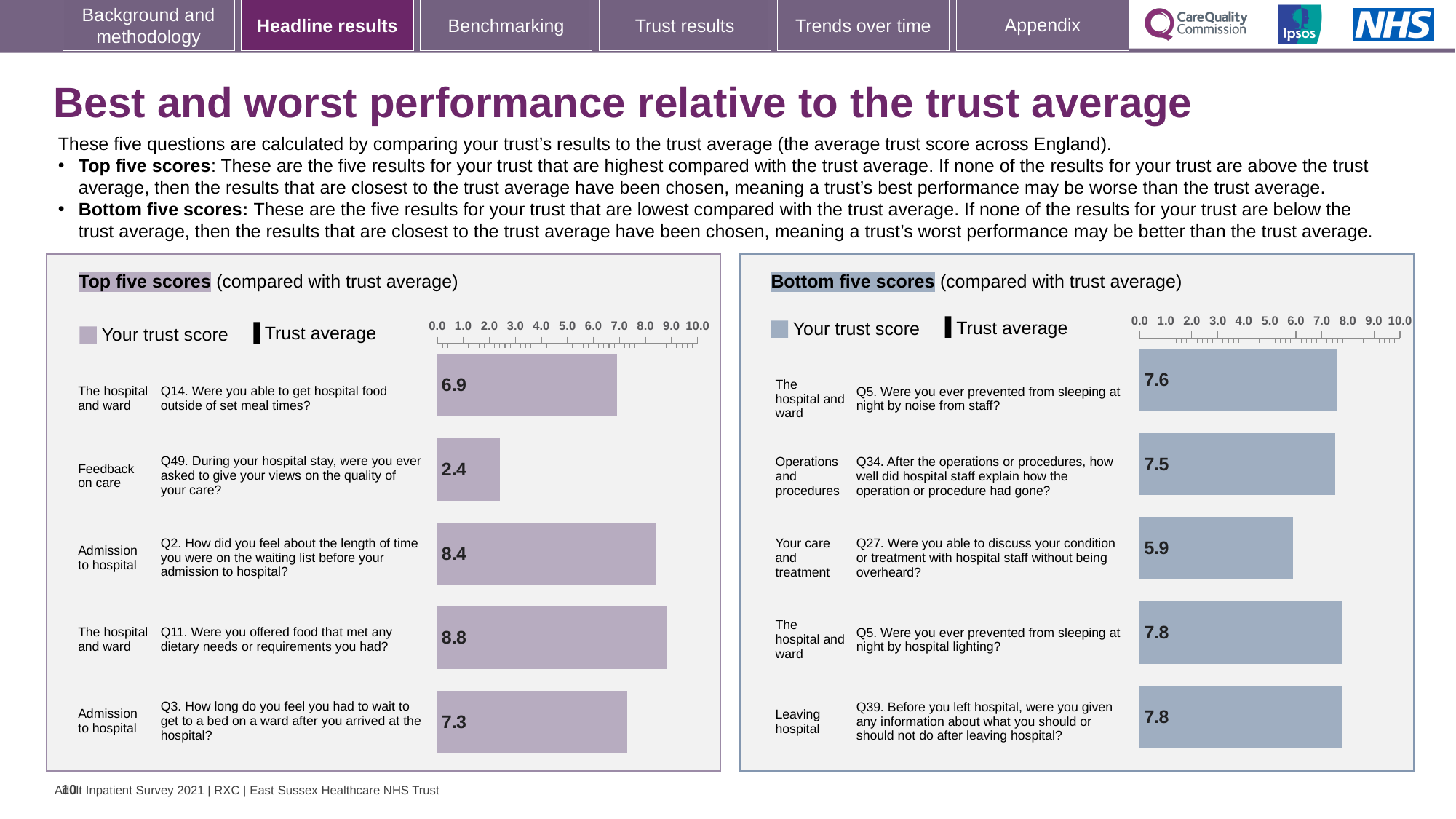
In the Bottom five scores chart, what is the trust score for Q34 (how well did hospital staff explain how the operation or procedure had gone)? 7.5 What kind of chart is used in the Top five scores panel? Bar chart In the Bottom five scores chart, what is the difference between the trust scores for Q39 and Q27? 1.9 In the Top five scores chart, which question has the highest trust score? Q11. Were you offered food that met any dietary needs or requirements you had? In the Bottom five scores chart, is the trust score for Q5 (prevented from sleeping at night by noise from staff) larger or smaller than the score for Q34? larger In the Bottom five scores chart, what is the trust score for Q27 (discuss your condition or treatment without being overheard)? 5.9 In the Top five scores chart, what is the difference between the trust scores for Q11 and Q2? 0.4 In the Top five scores chart, what is the trust score for Q49 (asked to give your views on the quality of your care)? 2.4 In the Top five scores chart, what is the trust score for Q14 (able to get hospital food outside of set meal times)? 6.9 In the Top five scores chart, which question has the lowest trust score? Q49. During your hospital stay, were you ever asked to give your views on the quality of your care? In the Bottom five scores chart, which question has the lowest trust score? Q27. Were you able to discuss your condition or treatment with hospital staff without being overheard? In the Top five scores chart, how many questions are plotted? 5